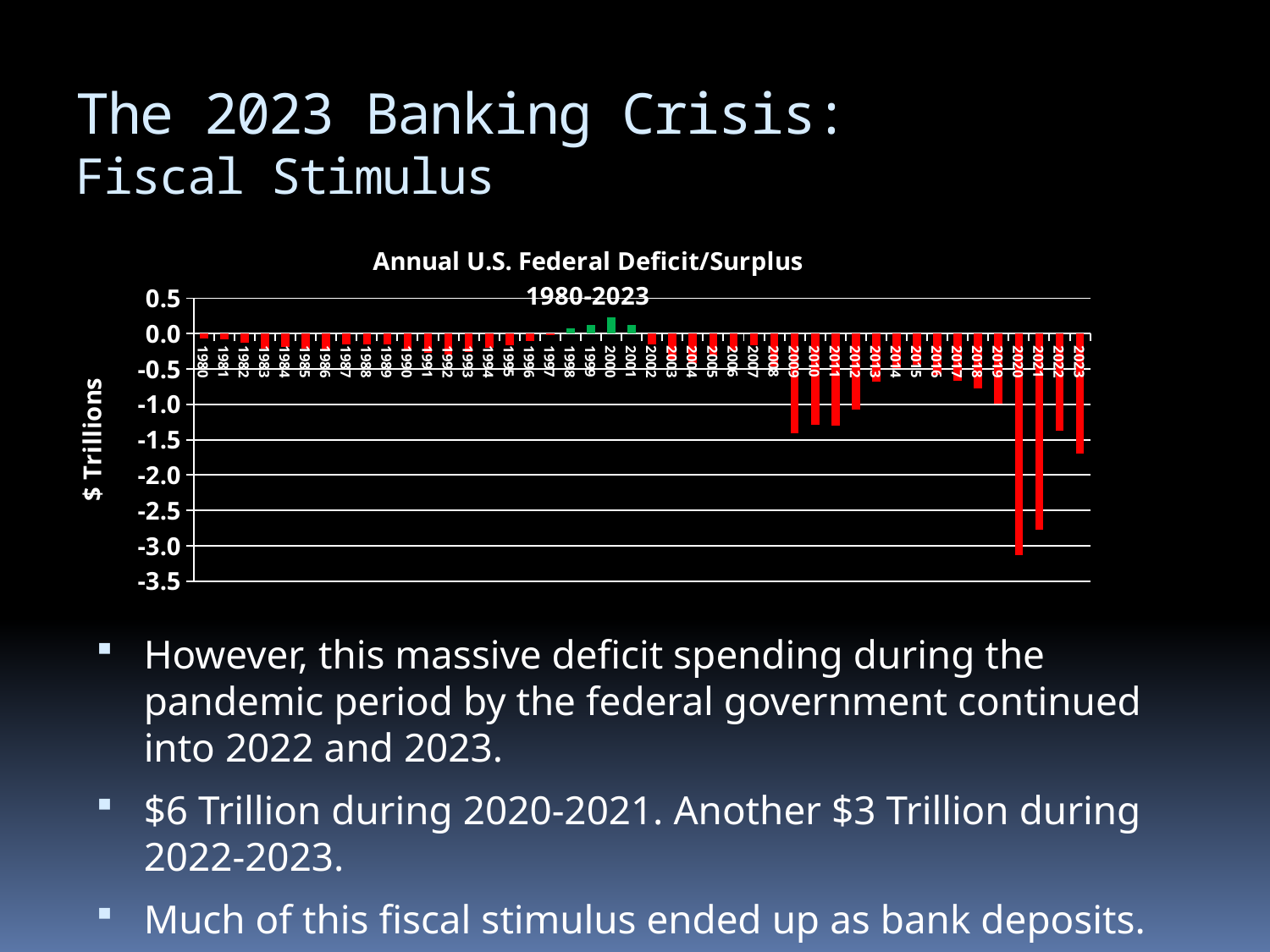
Which year has the highest value (largest surplus) on the chart? 2000 Is the value for 2020 greater or less than -2.5? less Which year shows the larger deficit, 2020 or 2021? 2020 Is the value for 2021 greater or less than -2.5? less What kind of chart is shown on the slide? Bar chart Is the value for 2023 greater or less than -1.5? less What is the label on the vertical axis of the chart? $ Trillions Which year has the lowest value (largest deficit) on the chart? 2020 How many years are plotted on the chart? 44 What is the title of the chart? Annual U.S. Federal Deficit/Surplus 1980-2023 Which year shows the larger deficit, 2022 or 2023? 2023